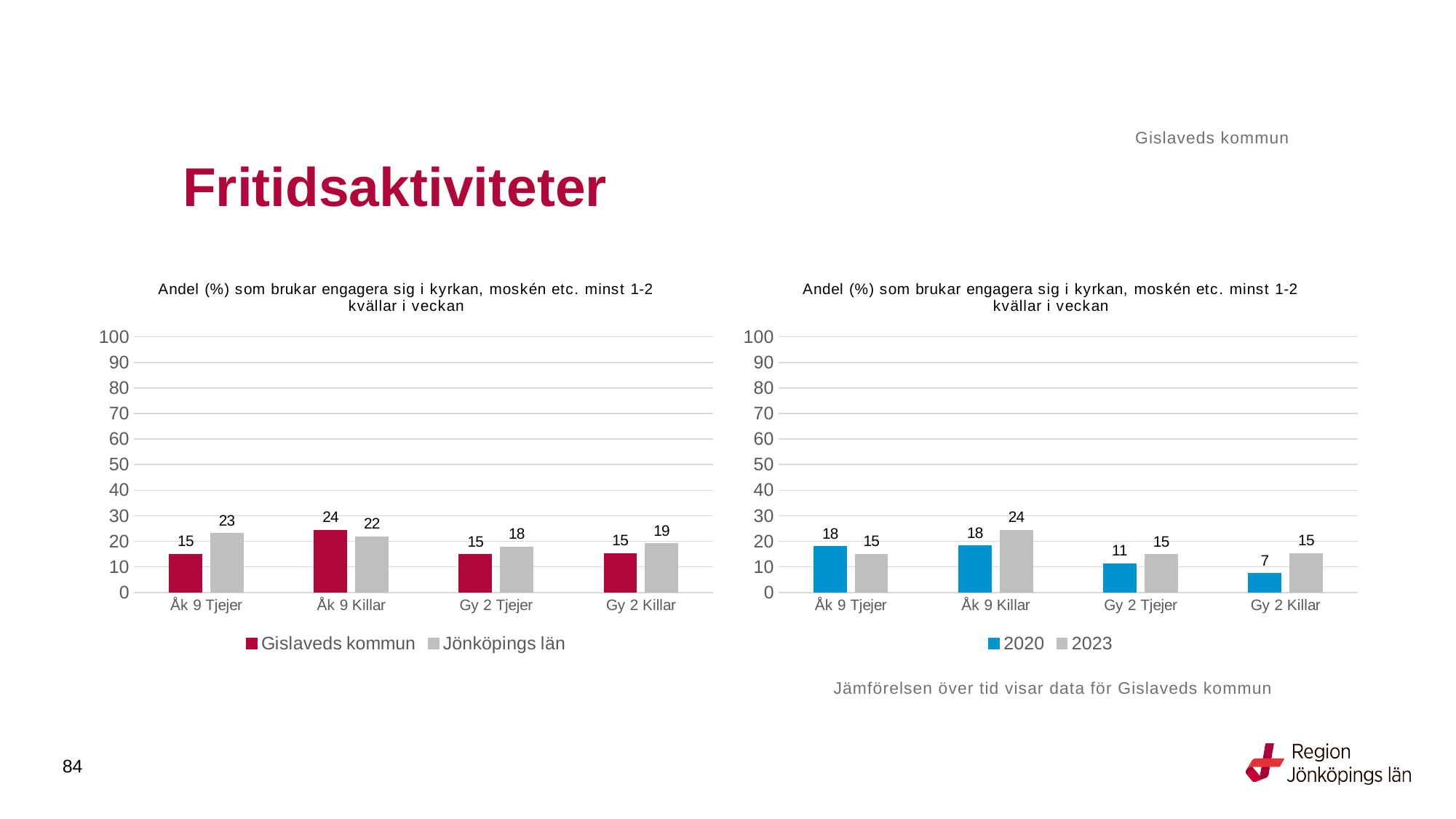
In the left chart, what is the difference between Jönköpings län and Gislaveds kommun for Åk 9 Tjejer? 8 In the right chart, what is the 2023 value for Åk 9 Killar? 24 In the left chart, what is the value for Gislaveds kommun for Åk 9 Killar? 24 In the left chart, what is the value for Jönköpings län for Gy 2 Killar? 19 In the right chart, which category has the lowest 2020 value? Gy 2 Killar In the right chart, what is the 2020 value for Gy 2 Killar? 7 How many categories are shown on the x axis of the left chart? 4 How many series does the legend of the right chart list? 2 In the right chart, which is larger for Åk 9 Tjejer: the 2020 value or the 2023 value? 2020 In the left chart, which category has the highest value for Gislaveds kommun? Åk 9 Killar In the right chart, what is the difference between the 2023 and 2020 values for Gy 2 Killar? 8 What type of chart is the left chart? Bar chart